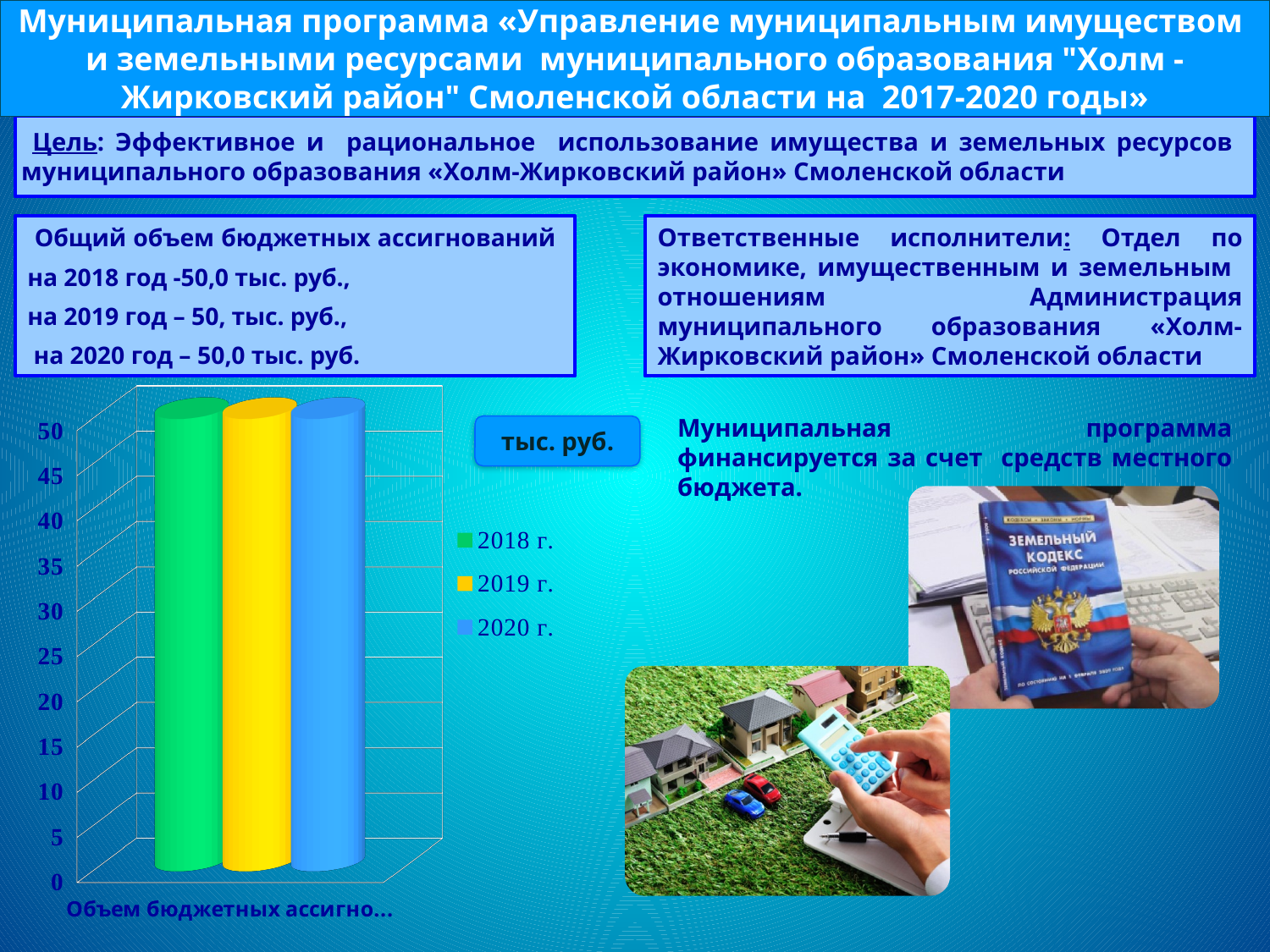
What is the highest tick value shown on the vertical axis of the chart? 50 How many series does the chart legend list? 3 What kind of chart is shown on the slide? bar chart What value does the bar for 2020 г. reach on the axis? 50 How many bars are plotted in the chart? 3 Do the values rise, fall, or stay the same from 2018 г. to 2020 г.? stay the same What value does the bar for 2019 г. reach on the axis? 50 What value does the bar for 2018 г. reach on the axis? 50 Is the value for 2018 г. greater or less than 40? greater Is the value for 2020 г. greater or less than 45? greater Which colour represents 2019 г. in the chart legend? yellow